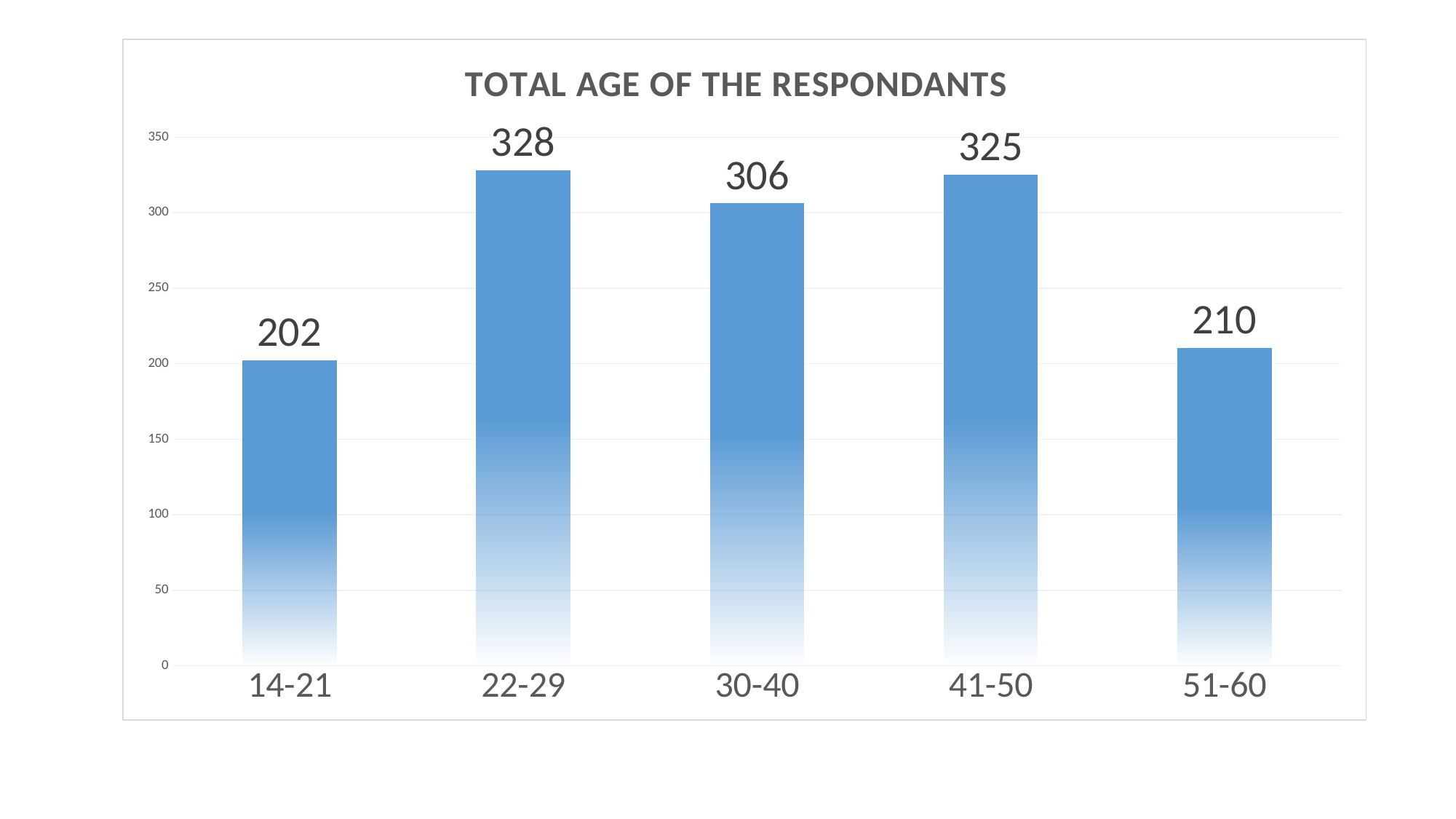
How many age groups are shown on the chart? 5 What is the value for the 14-21 age group? 202 Which age group has the highest value? 22-29 What is the value for the 51-60 age group? 210 Which is larger, the value for 30-40 or the value for 51-60? 30-40 What is the value for the 30-40 age group? 306 What is the value for the 22-29 age group? 328 What is the difference between the values for 22-29 and 14-21? 126 Which age group has the lowest value? 14-21 What kind of chart is shown on the slide? Bar chart What is the difference between the values for 41-50 and 51-60? 115 What is the title of the chart? TOTAL AGE OF THE RESPONDANTS